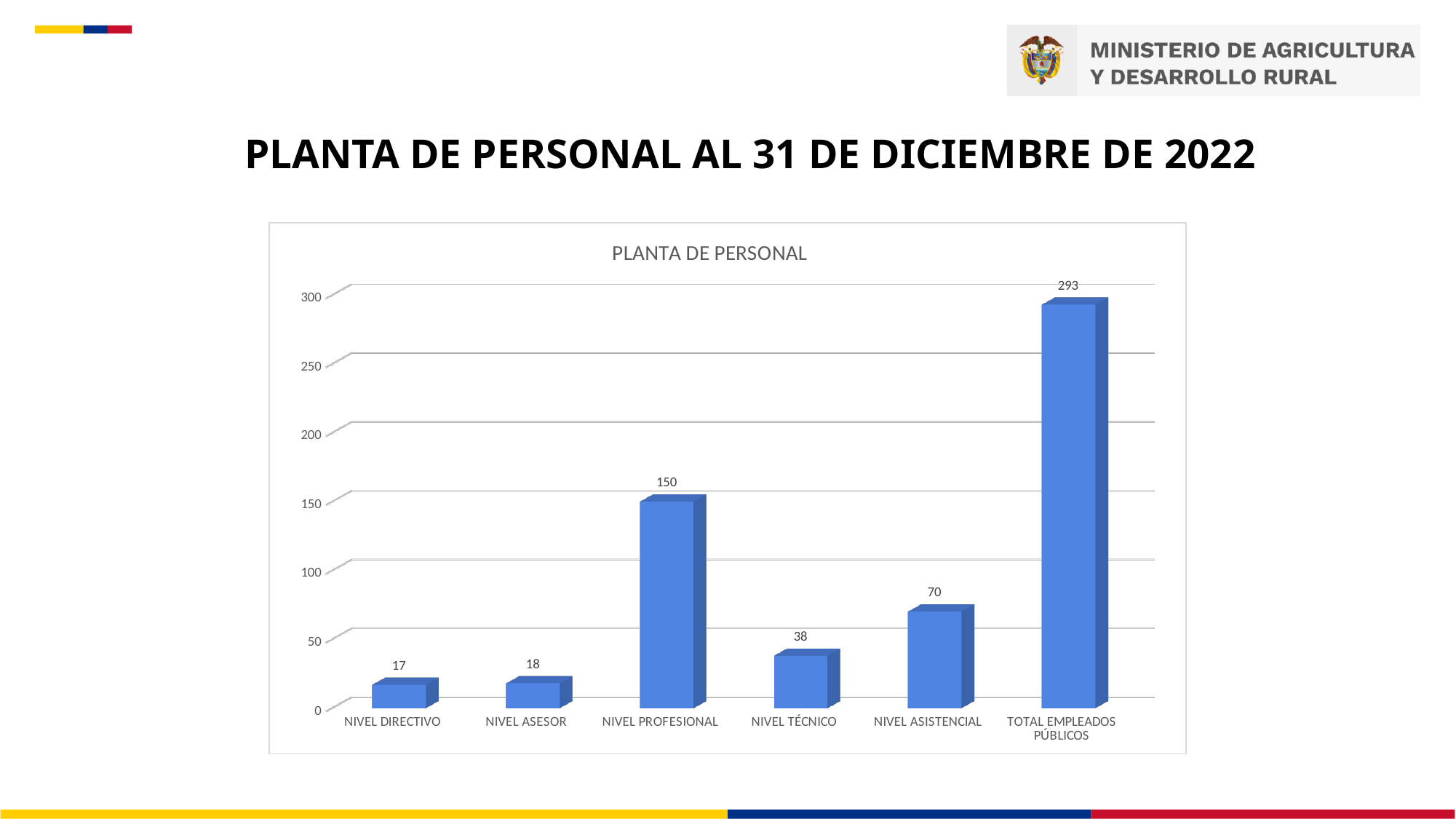
Which is larger, the value for NIVEL TÉCNICO or the value for NIVEL ASESOR? NIVEL TÉCNICO Which category has the highest value? TOTAL EMPLEADOS PÚBLICOS What is the difference between the values for NIVEL PROFESIONAL and NIVEL ASISTENCIAL? 80 What is the value for TOTAL EMPLEADOS PÚBLICOS? 293 How many categories are shown on the x axis? 6 What is the title of the chart? PLANTA DE PERSONAL What is the value for NIVEL TÉCNICO? 38 What kind of chart is shown on the slide? bar chart Is the value for NIVEL ASISTENCIAL greater or less than 100? less Which category has the lowest value? NIVEL DIRECTIVO What is the value for NIVEL PROFESIONAL? 150 What is the value for NIVEL ASISTENCIAL? 70